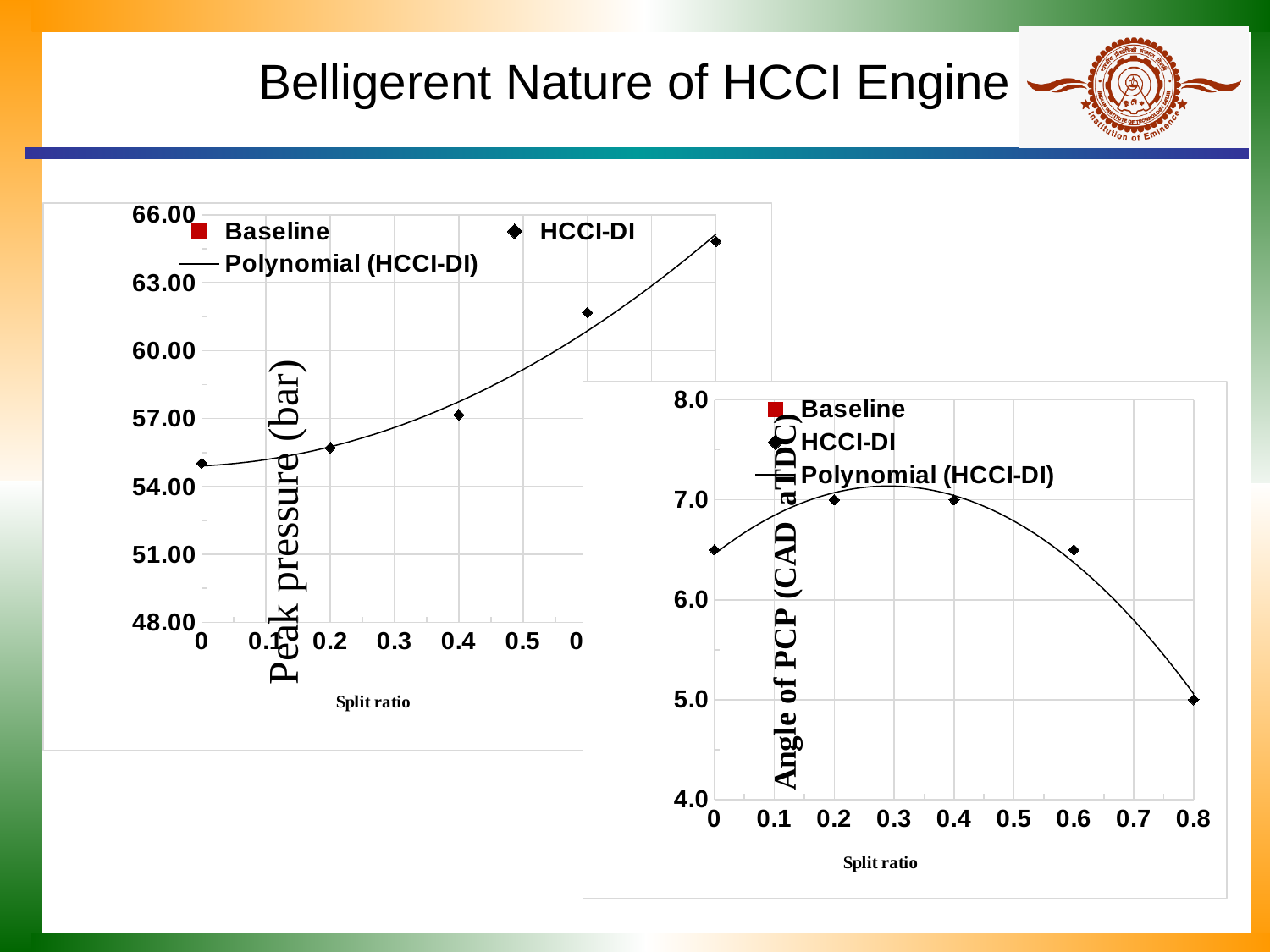
In the right chart, Angle of PCP (CAD aTDC), which is larger: the HCCI-DI value at split ratio 0.2 or at 0.8? 0.2 In the right chart, Angle of PCP (CAD aTDC), what is the HCCI-DI value at a split ratio of 0.2? 7.0 In the left chart, Peak pressure (bar), do the HCCI-DI values rise or fall as the split ratio increases? Rise In the right chart, Angle of PCP (CAD aTDC), what is the HCCI-DI value at a split ratio of 0.8? 5.0 In the right chart, Angle of PCP (CAD aTDC), what is the difference between the HCCI-DI values at split ratios 0.2 and 0.8? 2.0 In the left chart, Peak pressure (bar), is the HCCI-DI value at split ratio 0 greater or less than 54.00? greater In the right chart, Angle of PCP (CAD aTDC), at which split ratio is the HCCI-DI value lowest? 0.8 In the right chart, Angle of PCP (CAD aTDC), is the HCCI-DI value at split ratio 0 greater or less than 6.0? greater How many HCCI-DI data points are plotted in the right chart, Angle of PCP (CAD aTDC)? 5 How many entries does the legend of the right chart, Angle of PCP (CAD aTDC), list? 3 In the left chart, Peak pressure (bar), is the HCCI-DI value at split ratio 0.2 greater or less than 57.00? less What kind of chart is the left chart, Peak pressure (bar) versus Split ratio? Scatter chart with a polynomial trendline